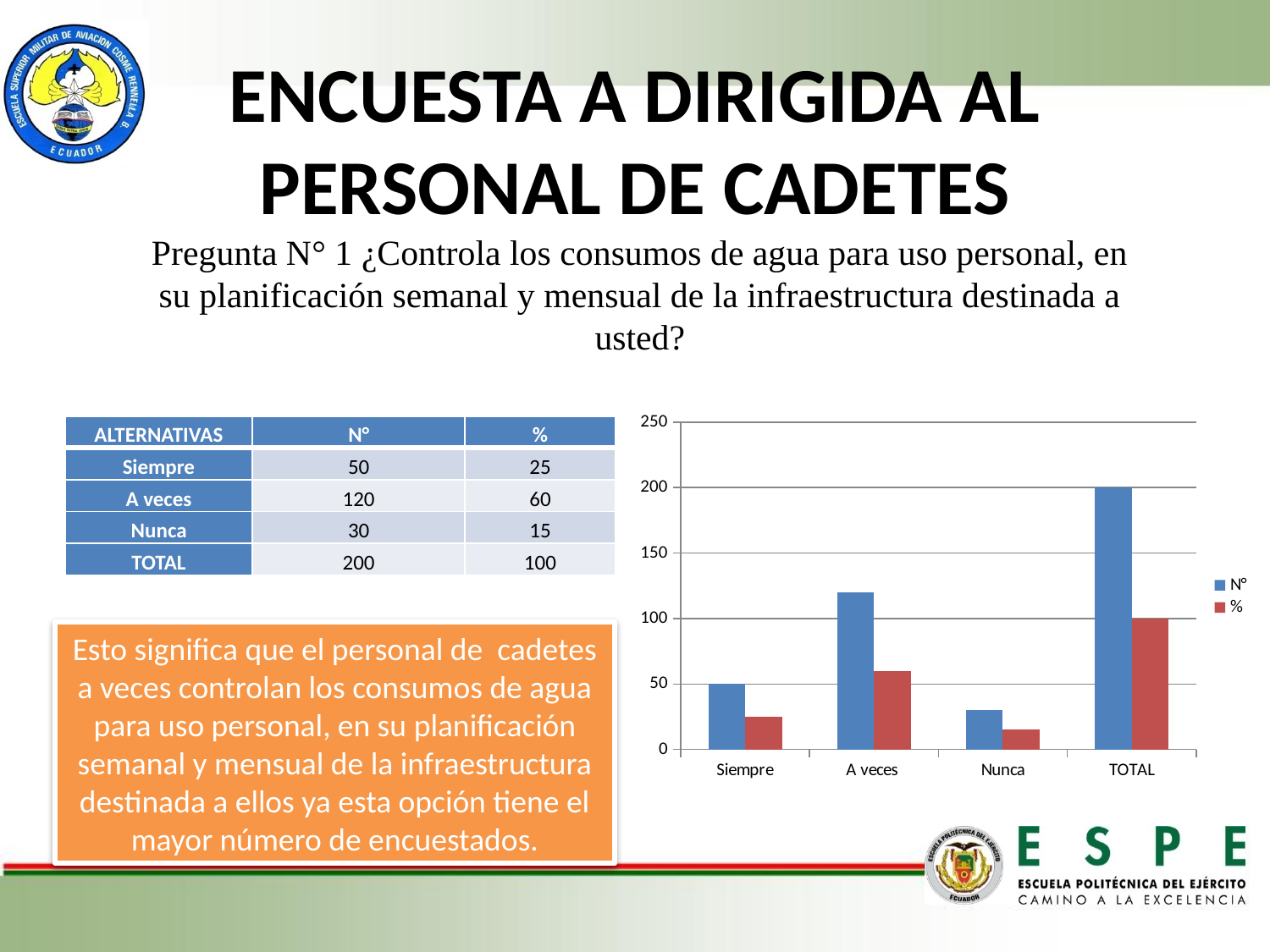
How many series does the chart legend list? 2 Which category has the highest N° value, excluding TOTAL? A veces What kind of chart is shown on the slide? bar chart What is the N° value for A veces? 120 What is the % value for Siempre? 25 Which category has the lowest % value? Nunca What is the N° value for TOTAL? 200 How many categories are shown on the x axis of the chart? 4 What is the difference between the N° values for A veces and Siempre? 70 Which is larger, the N° value for Siempre or the N° value for Nunca? Siempre Which series is shown in blue in the chart? N° Is the N° value for A veces greater or less than 100? greater